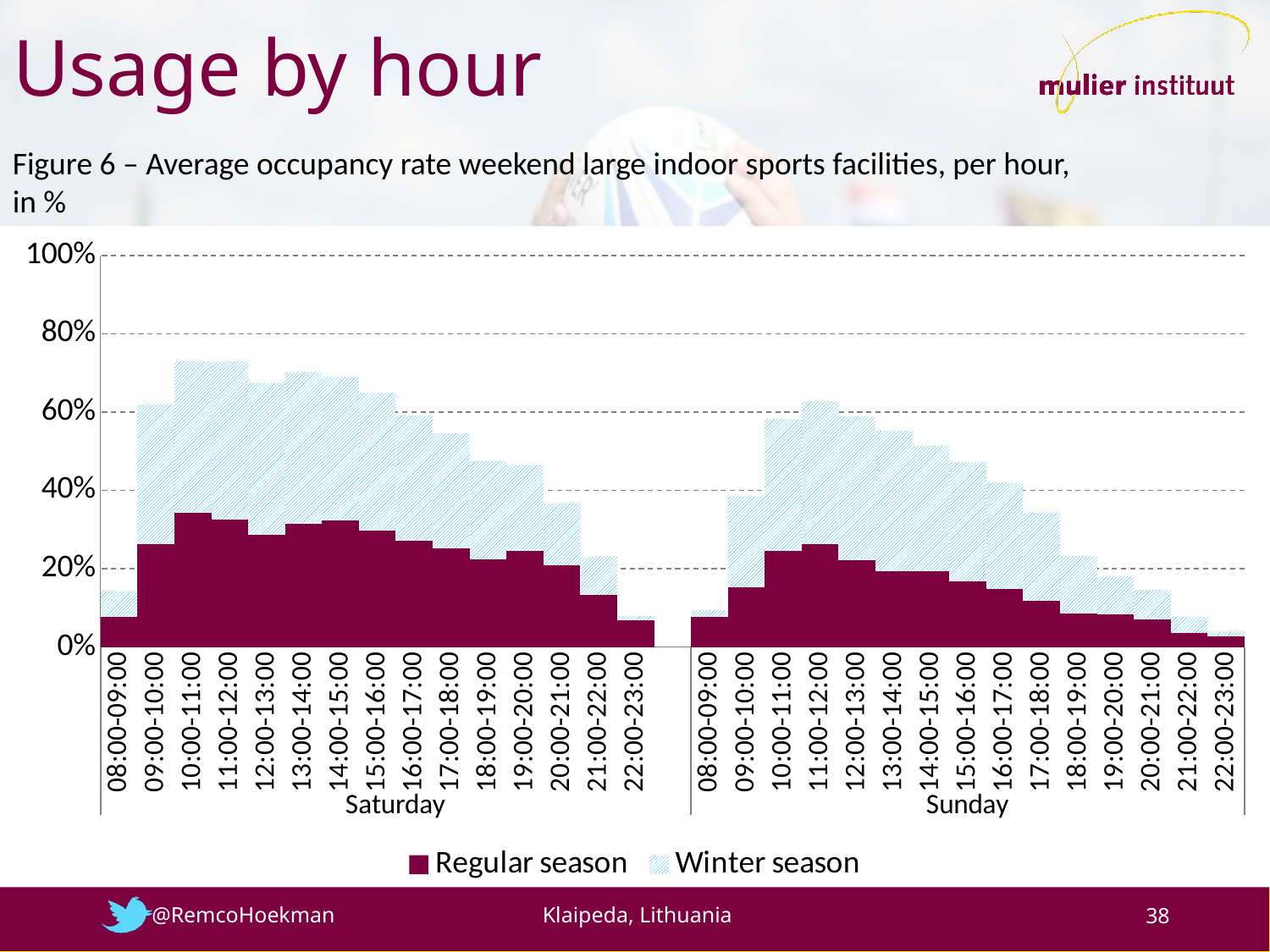
Is the Winter season value for Sunday 09:00-10:00 greater or less than 20%? greater How many series does the legend list? 2 For the Regular season at 10:00-11:00, which day has the larger value, Saturday or Sunday? Saturday For Saturday 09:00-10:00, which series has the larger value, Regular season or Winter season? Winter season Is the Regular season value for Saturday 10:00-11:00 greater or less than 40%? less Which two days are shown as groups along the x axis? Saturday and Sunday Is the Winter season value for Saturday 10:00-11:00 greater or less than 60%? less What are the two series named in the legend? Regular season and Winter season How many hourly time slots are shown for Saturday? 15 What kind of chart is shown on the slide? Bar chart